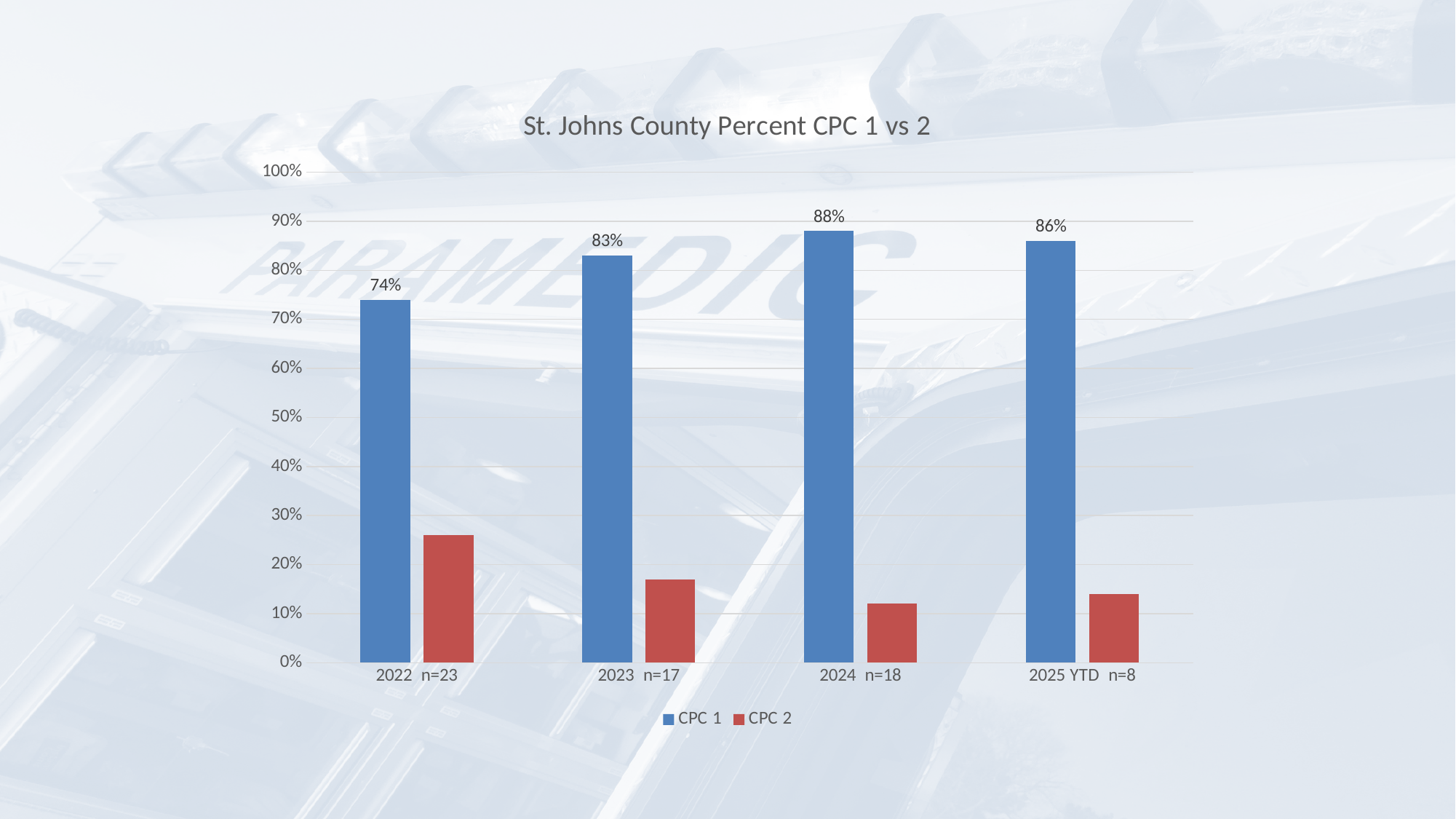
Which year has the highest CPC 1 percentage? 2024 What is the CPC 1 value for 2025 YTD (n=8)? 86% What is the CPC 1 value for 2024 (n=18)? 88% What type of chart is shown on the slide? Bar chart Which year has the lowest CPC 1 percentage? 2022 Which is larger, the CPC 1 value for 2023 or the CPC 1 value for 2025 YTD? 2025 YTD Is the CPC 2 value for 2024 greater or less than 20%? less How many series does the legend list? 2 Is the CPC 2 value for 2022 greater or less than 20%? greater How many year categories are shown on the x axis? 4 What is the CPC 1 value for 2022 (n=23)? 74% What is the difference between the CPC 1 value for 2024 and the CPC 1 value for 2022? 14 percentage points